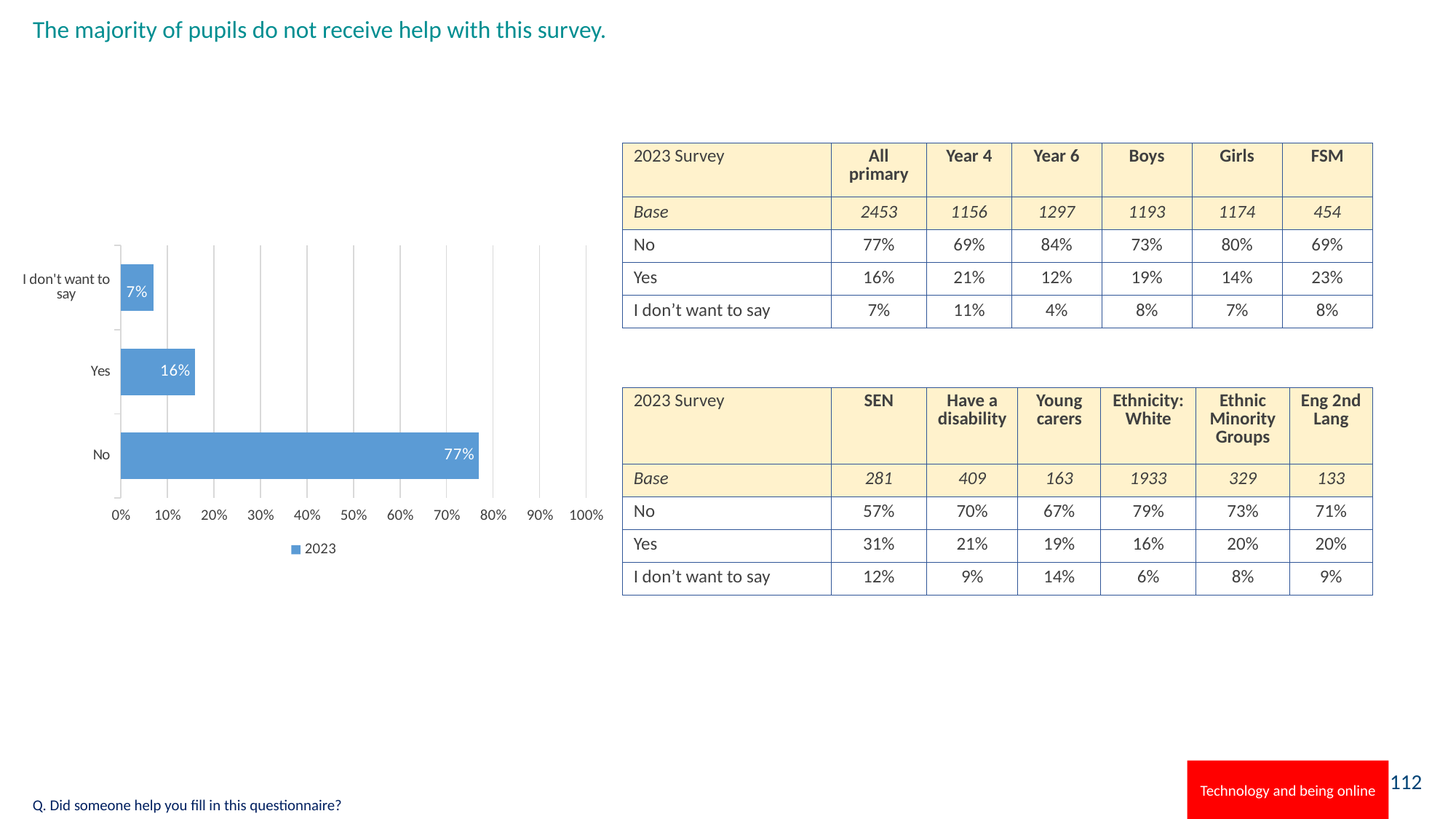
What is the difference between the values for "Yes" and "I don't want to say" in the bar chart? 9% What is the value for "I don't want to say" in the bar chart? 7% Which is larger in the bar chart, the value for "Yes" or the value for "I don't want to say"? Yes How many categories are shown in the bar chart? 3 Which category has the lowest value in the bar chart? I don't want to say What is the value for "No" in the bar chart? 77% What kind of chart is shown on the slide? Bar chart What is the value for "Yes" in the bar chart? 16% Is the value for "No" in the bar chart greater or less than 50%? greater How many series does the legend of the bar chart list? 1 What is the difference between the values for "No" and "Yes" in the bar chart? 61% Which category has the highest value in the bar chart? No